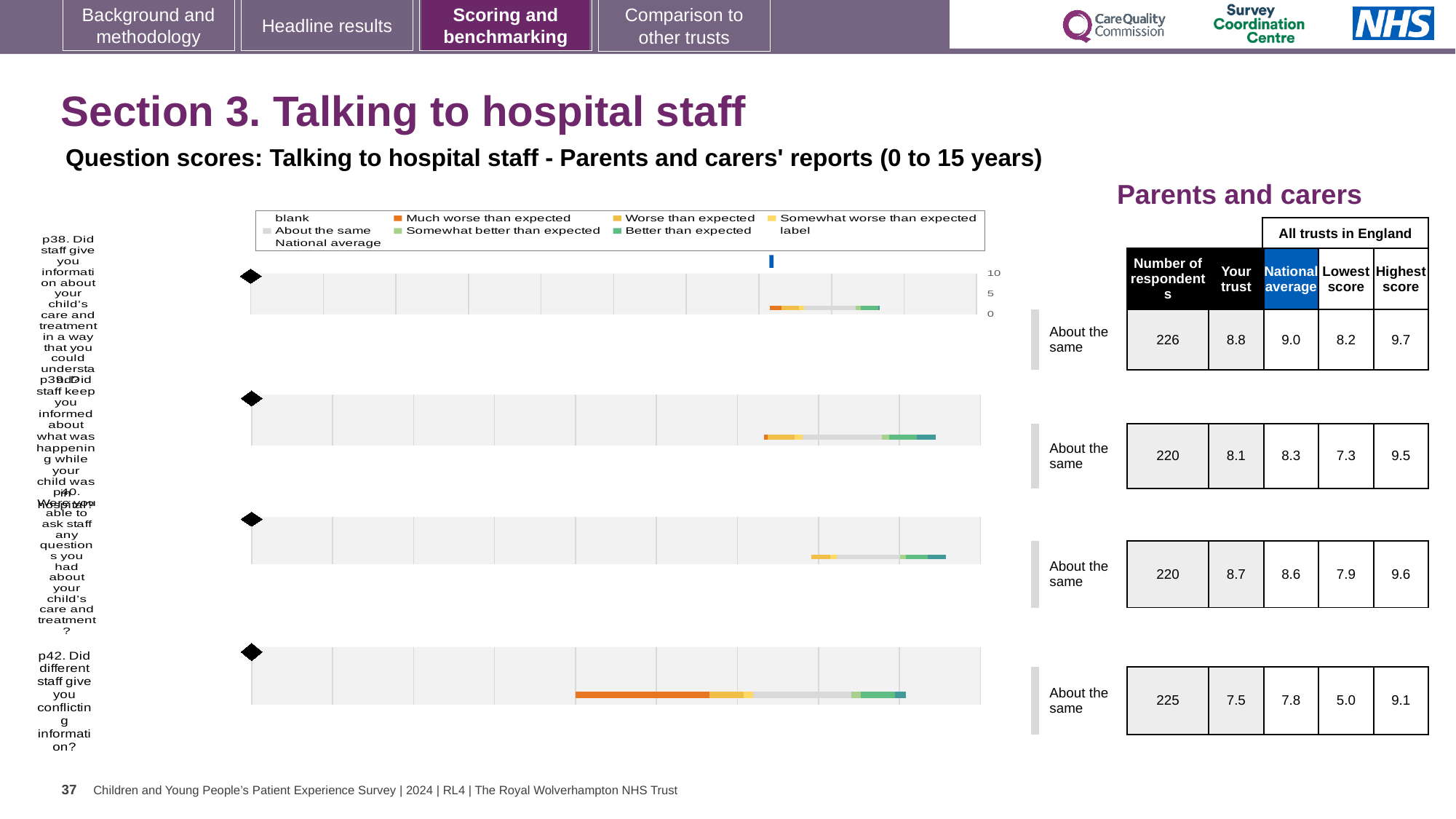
How many respondents are listed for p39 (Did staff keep you informed about what was happening while your child was in hospital)? 220 For p40 (Were you able to ask staff any questions you had about your child's care and treatment?), is the 'Your trust' score or the national average higher? Your trust What benchmark category is shown next to the chart for p38 (Did staff give you information about your child's care and treatment in a way that you could understand)? About the same For p42 (Did different staff give you conflicting information?), what is the national average score? 7.8 Is the 'Your trust' score for p39 greater or less than the national average? less Which question has the lowest 'Your trust' score on this slide? p42 How many survey questions (p38, p39, p40, p42) have a bar chart on this slide? 4 For p42, what is the difference between the highest score and the lowest score across all trusts in England? 4.1 What kind of chart is used to show the question scores on this slide? bar chart For p38, what is the 'Your trust' score shown in the table? 8.8 What is the highest score across all trusts in England for p38? 9.7 In the chart legend, which colour represents 'Much worse than expected'? orange